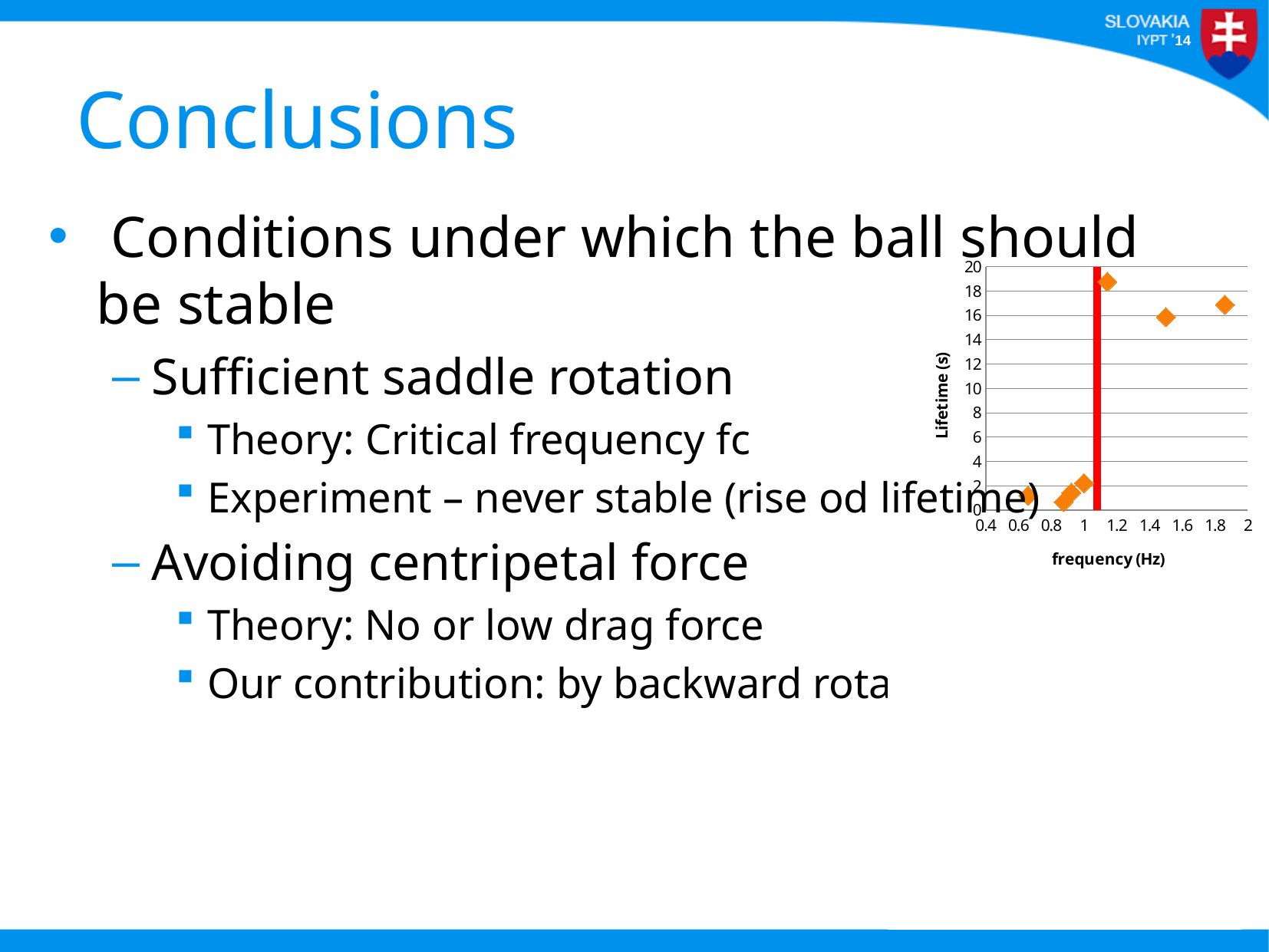
Is the lifetime of the data point near 1.5 Hz greater or less than 10? greater Is the lifetime of the data point just to the right of the red vertical line greater or less than 10? greater What is the label of the y axis of the chart? Lifetime (s) Are the lifetimes of the data points below 1 Hz greater or less than 4? less Overall, does lifetime rise or fall as frequency increases along the x axis? rise Which data point has the higher lifetime: the one near 1.5 Hz or the one near 0.9 Hz? the one near 1.5 Hz What is the highest value shown on the y axis of the chart? 20 What kind of chart is shown on the slide? scatter chart What is the highest value shown on the x axis of the chart? 2 Which data point has the higher lifetime: the one just right of the red line (near 1.15 Hz) or the one near 1.5 Hz? the one near 1.15 Hz What is the label of the x axis of the chart? frequency (Hz)